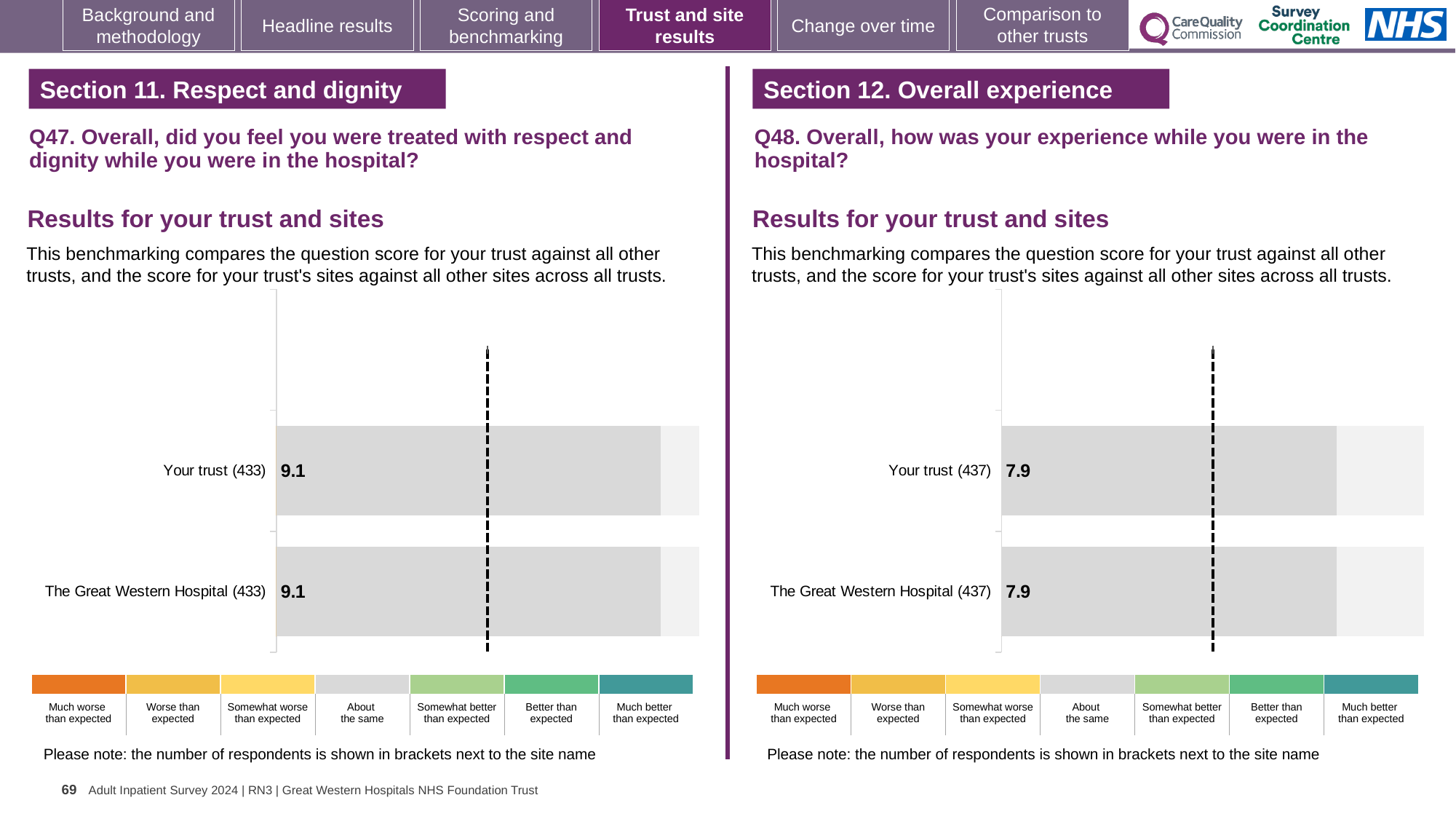
In the Section 11 (Q47) chart on the left, how many respondents are shown in brackets for Your trust? 433 In the Section 12 (Q48) chart on the right, how many categories does the colour key below the chart list? 7 In the Section 12 (Q48) chart on the right, how many bars (categories) are plotted? 2 In the Section 12 (Q48) chart on the right, how many respondents are shown in brackets for The Great Western Hospital? 437 What type of chart is used in the Section 11 (Q47) chart on the left? Bar chart In the Section 11 (Q47) chart on the left, what is the score for The Great Western Hospital? 9.1 In the Section 11 (Q47) chart on the left, what is the score for Your trust? 9.1 What is the title of the section shown above the chart on the right? Section 12. Overall experience In the Section 12 (Q48) chart on the right, what is the score for The Great Western Hospital? 7.9 In the Section 11 (Q47) chart on the left, what is the difference between the score for Your trust and the score for The Great Western Hospital? 0 In the Section 12 (Q48) chart on the right, what is the score for Your trust? 7.9 Is the score for Your trust in the Section 11 (Q47) chart on the left larger than the score for Your trust in the Section 12 (Q48) chart on the right? Yes